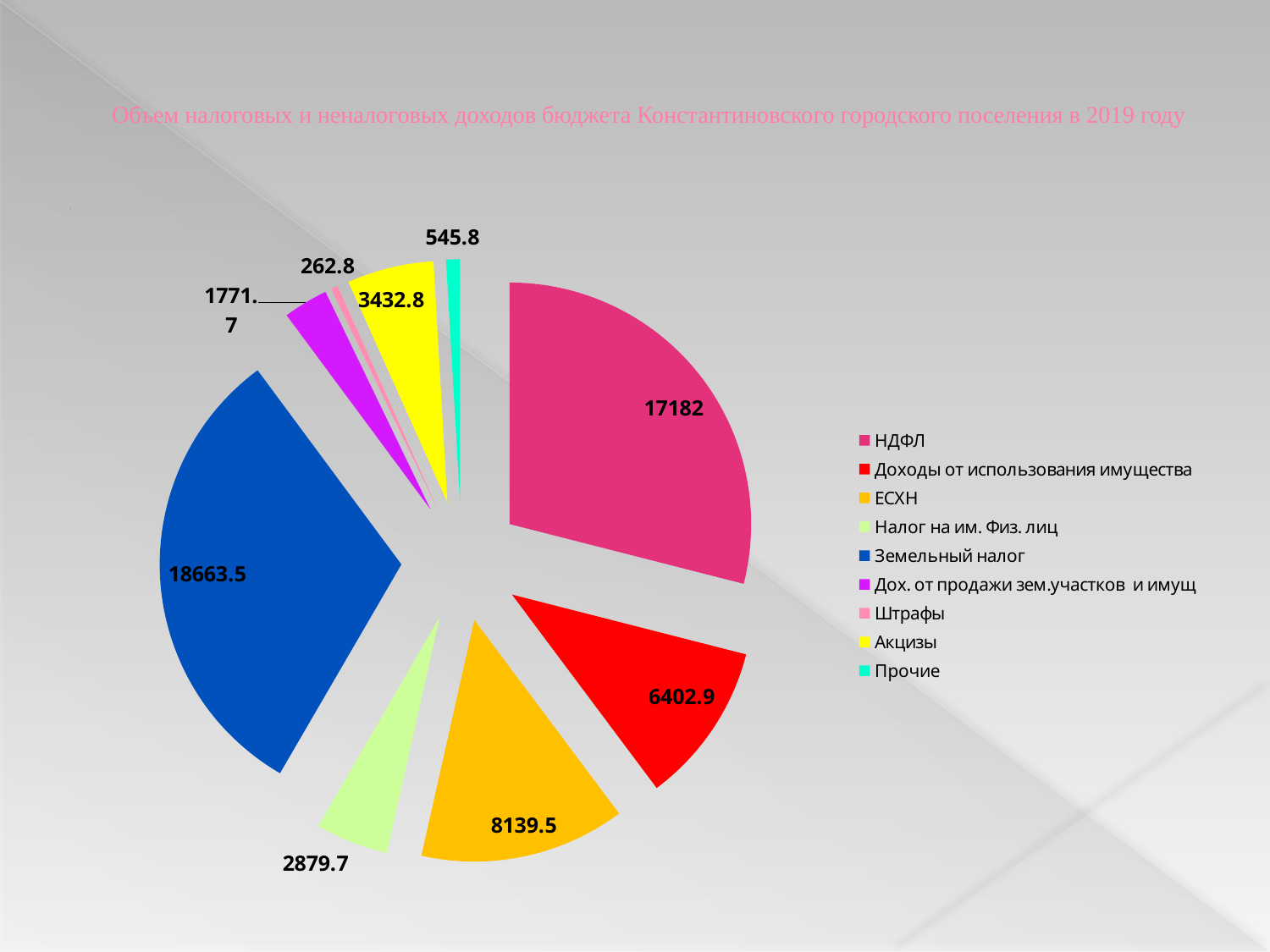
What is the value for ЕСХН? 8139.5 What is the difference between Земельный налог and НДФЛ? 1481.5 What is the value for НДФЛ? 17182 Which category has the largest slice? Земельный налог What is the difference between Акцизы and Налог на им. Физ. лиц? 553.1 What kind of chart is shown on the slide? Pie chart What is the value for Штрафы? 262.8 How many categories does the pie chart have? 9 What colour is the slice for Акцизы? Yellow What is the value for Земельный налог? 18663.5 Which category has the smallest slice? Штрафы Which is larger, ЕСХН or Доходы от использования имущества? ЕСХН